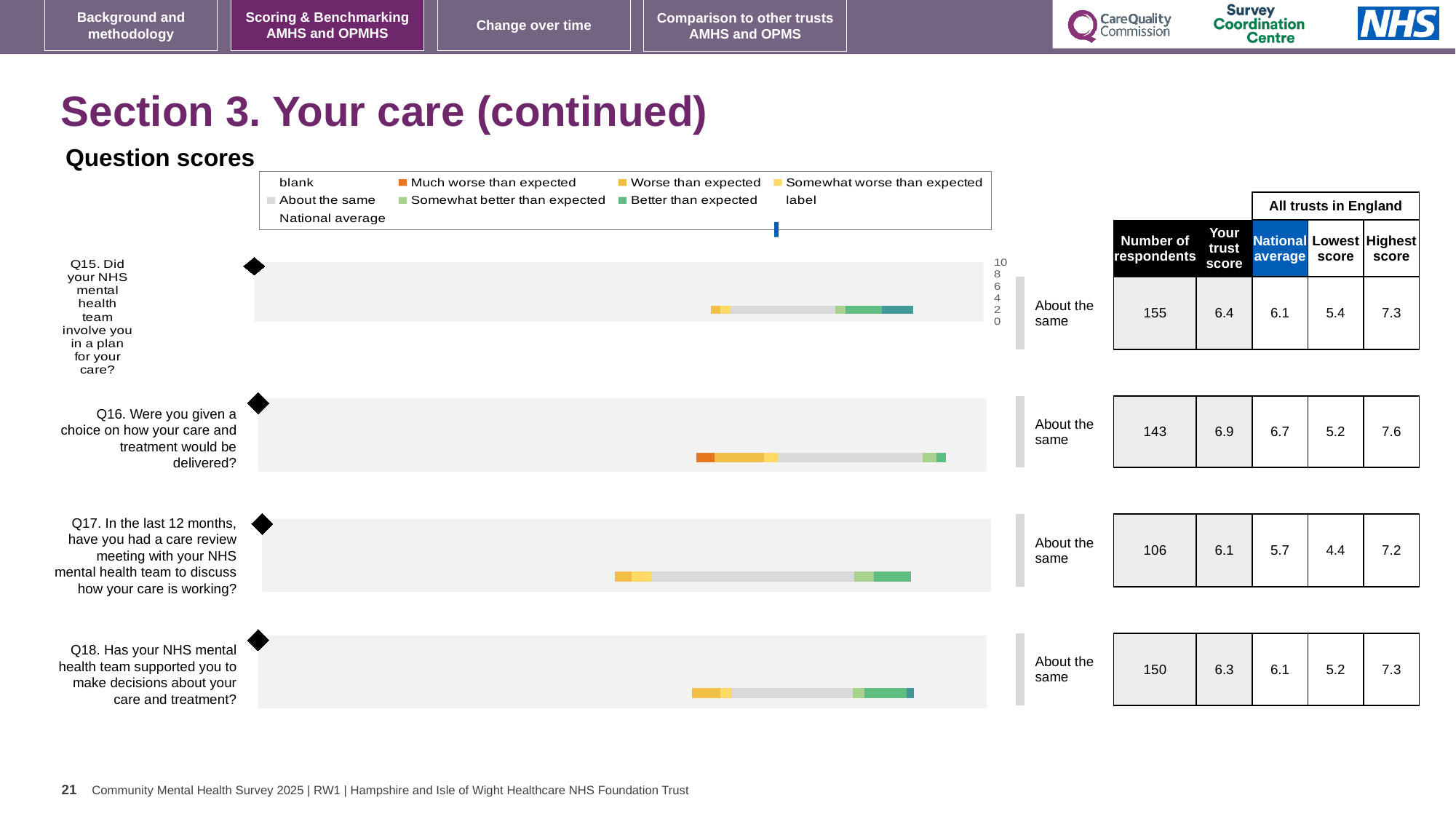
What is the number of respondents for Q15 (Did your NHS mental health team involve you in a plan for your care?)? 155 What is the title above the charts on this slide? Question scores What is the lowest score among all trusts in England for Q18? 5.2 For Q17, which is larger: the trust score or the national average? the trust score Which question has the highest trust score? Q16 What is the national average for Q17 (care review meeting in the last 12 months)? 5.7 What is the difference between the trust score and the national average for Q15? 0.3 What comparison label is shown next to the Q16 bar? About the same How many questions (Q15 to Q18) are plotted in the Question scores charts? 4 What kind of chart is used to show the question scores on this slide? bar chart Which question has the lowest number of respondents? Q17 What is the trust score for Q16 (Were you given a choice on how your care and treatment would be delivered?)? 6.9